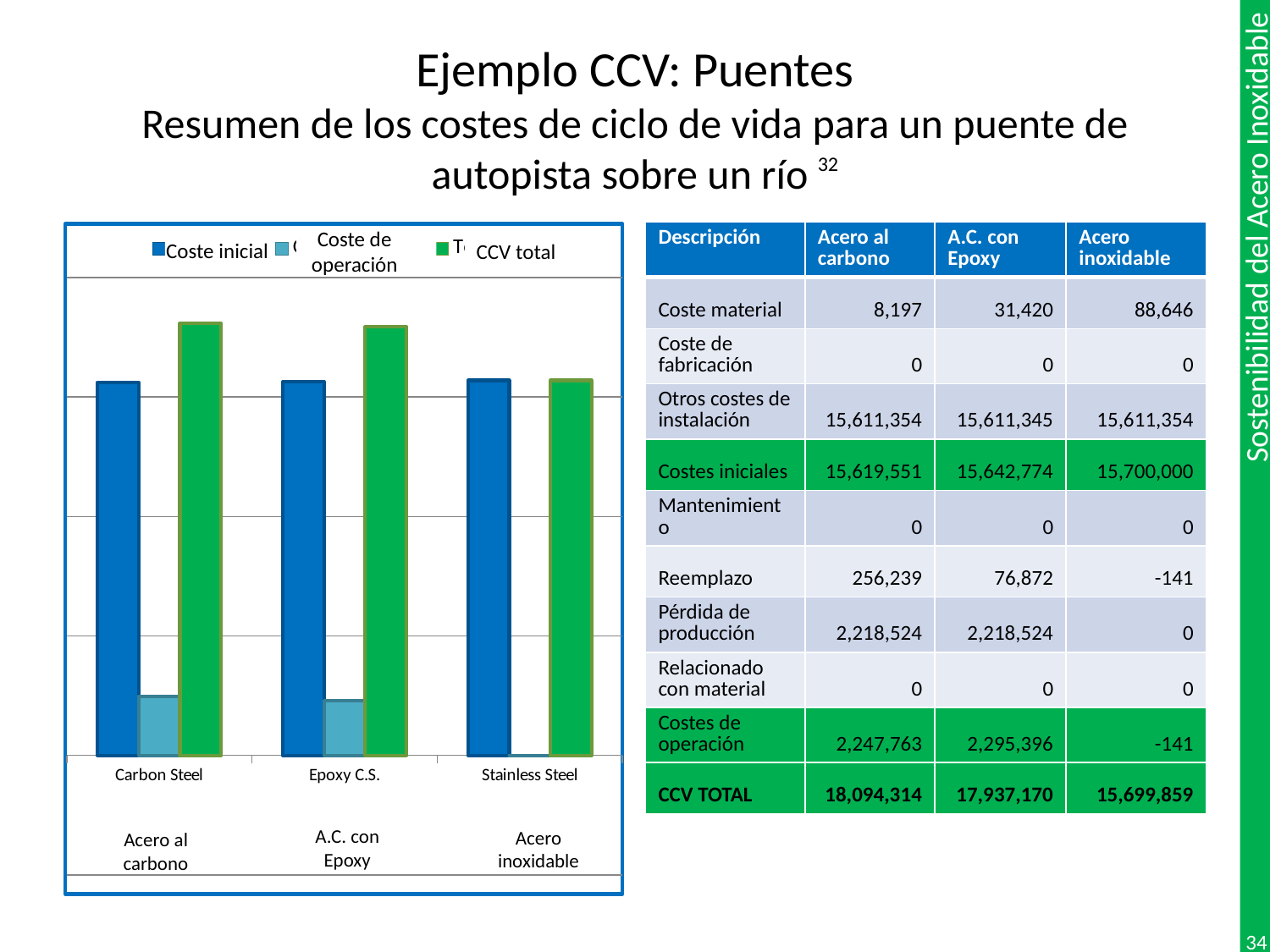
Which category has the lowest Coste de operación bar in the chart? Stainless Steel In the chart, is the Coste de operación bar larger for Epoxy C.S. or for Stainless Steel? Epoxy C.S. In the chart, is the Coste de operación bar larger for Carbon Steel or for Stainless Steel? Carbon Steel What is the label of the first category on the x axis of the chart? Carbon Steel In the chart, is the CCV total bar larger for Carbon Steel or for Stainless Steel? Carbon Steel Which series in the chart is drawn in green? CCV total How many categories are shown on the x axis of the chart? 3 What kind of chart is shown on the slide? bar chart How many series does the chart legend list? 3 Which category has the lowest CCV total bar in the chart? Stainless Steel